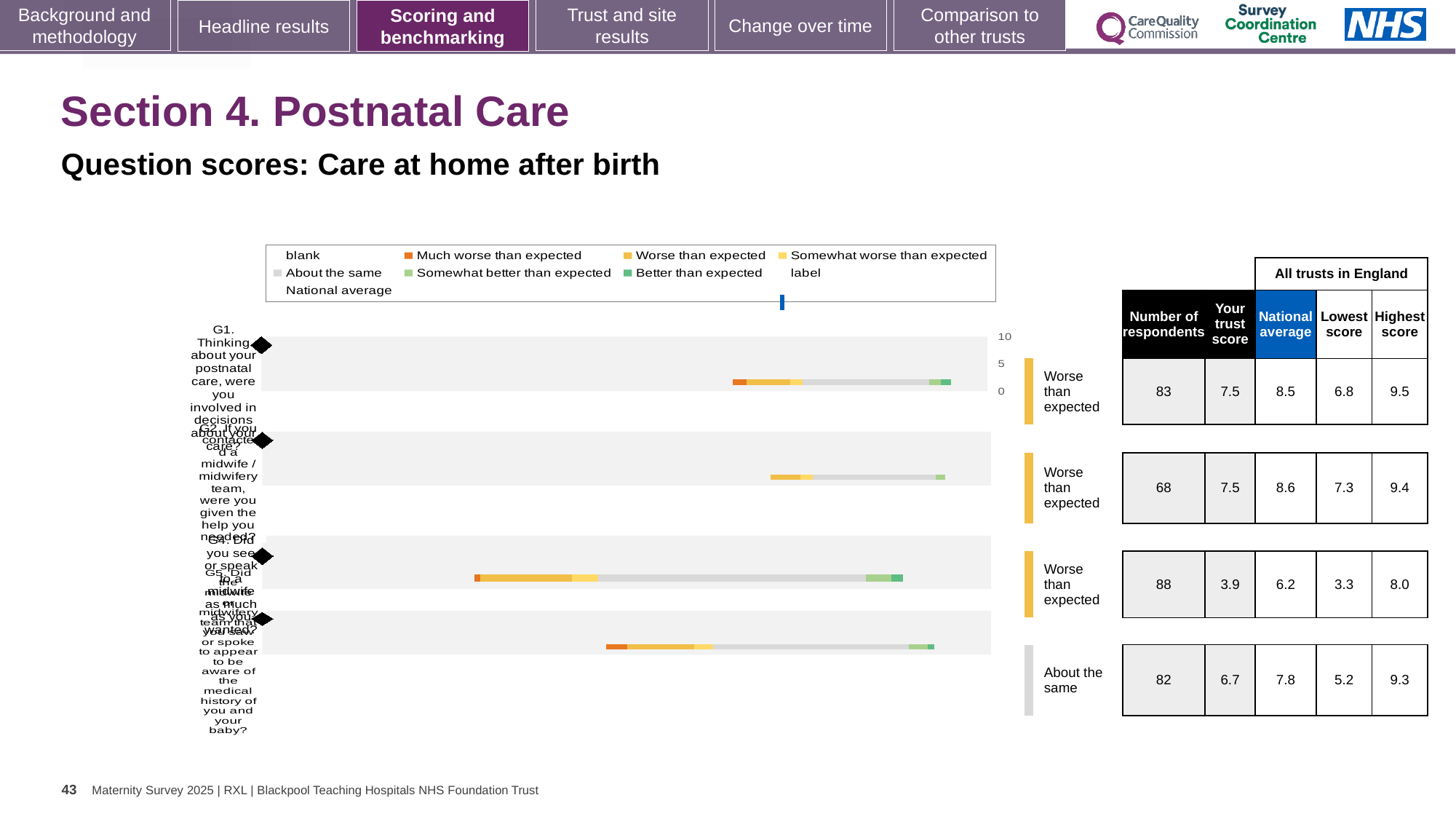
What is the national average for question G1? 8.5 What kind of chart is shown on the slide? Bar chart What is the highest score among all trusts in England for the third question? 8.0 How many of the questions are rated 'Worse than expected'? 3 What is the difference between the national average and the trust score for question G1? 1.0 What benchmark category is shown for the fourth (bottom) question? About the same How many respondents answered question G2 (contacted a midwife / midwifery team)? 68 Which row has the lowest 'Your trust score' in the table? The third row (3.9) For the fourth (bottom) question, which is larger: the trust score or the national average? National average What is the subtitle describing the chart's content? Question scores: Care at home after birth What is the 'Your trust score' for question G1 (involved in decisions about your care)? 7.5 How many question bars are plotted in the chart? 4